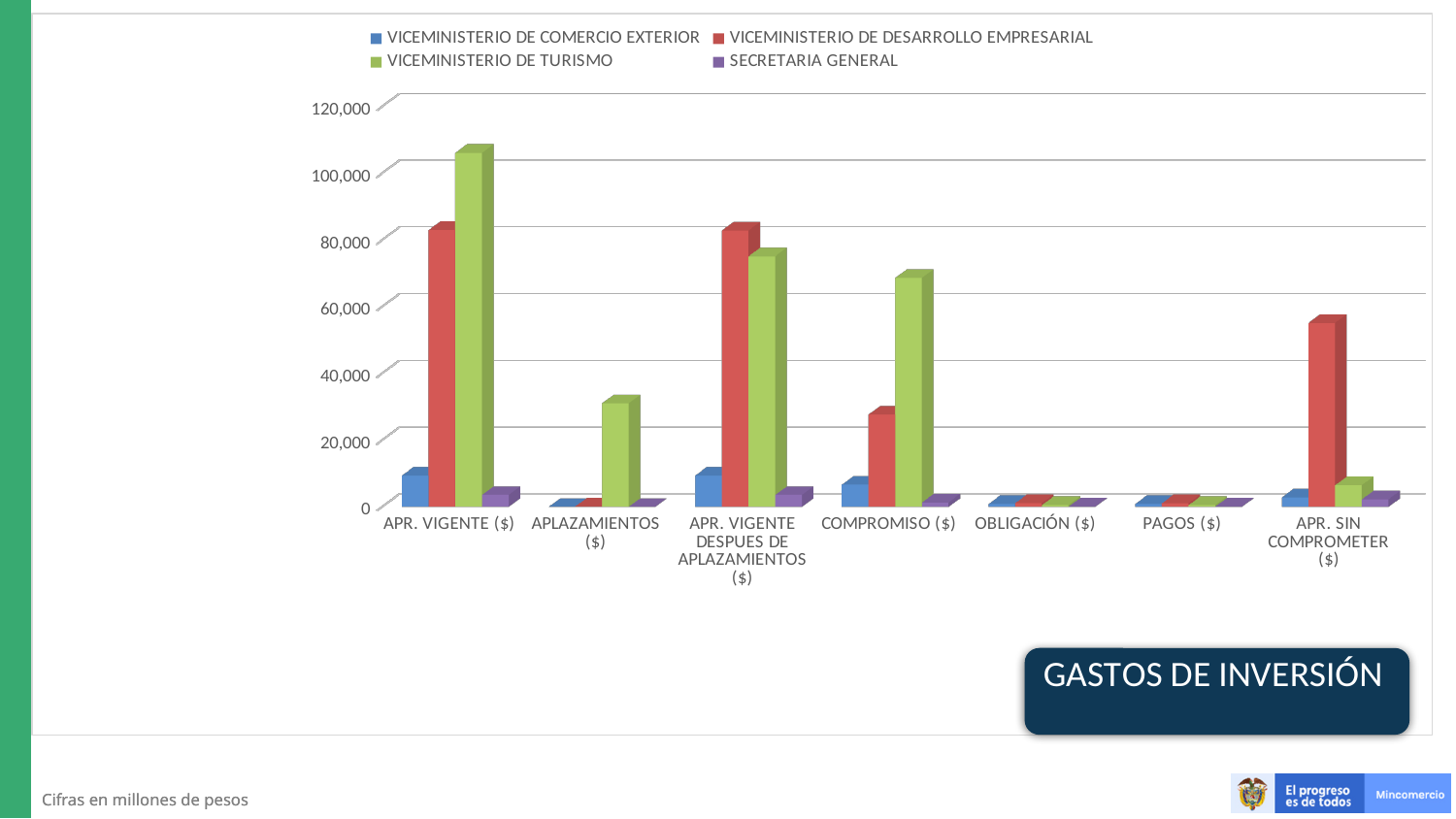
Is the value for VICEMINISTERIO DE COMERCIO EXTERIOR at APR. VIGENTE ($) greater or less than 20,000? less Is the value for VICEMINISTERIO DE DESARROLLO EMPRESARIAL at APR. SIN COMPROMETER ($) greater or less than 40,000? greater What text appears in the dark box at the bottom right of the chart? GASTOS DE INVERSIÓN How many categories are shown along the x axis? 7 At COMPROMISO ($), which is larger: VICEMINISTERIO DE DESARROLLO EMPRESARIAL or VICEMINISTERIO DE TURISMO? VICEMINISTERIO DE TURISMO What kind of chart is shown on the slide? bar chart How many series does the legend list? 4 Which series has the highest value at APR. SIN COMPROMETER ($)? VICEMINISTERIO DE DESARROLLO EMPRESARIAL Is the value for VICEMINISTERIO DE TURISMO at APR. VIGENTE ($) greater or less than 100,000? greater Which series has the highest value at COMPROMISO ($)? VICEMINISTERIO DE TURISMO